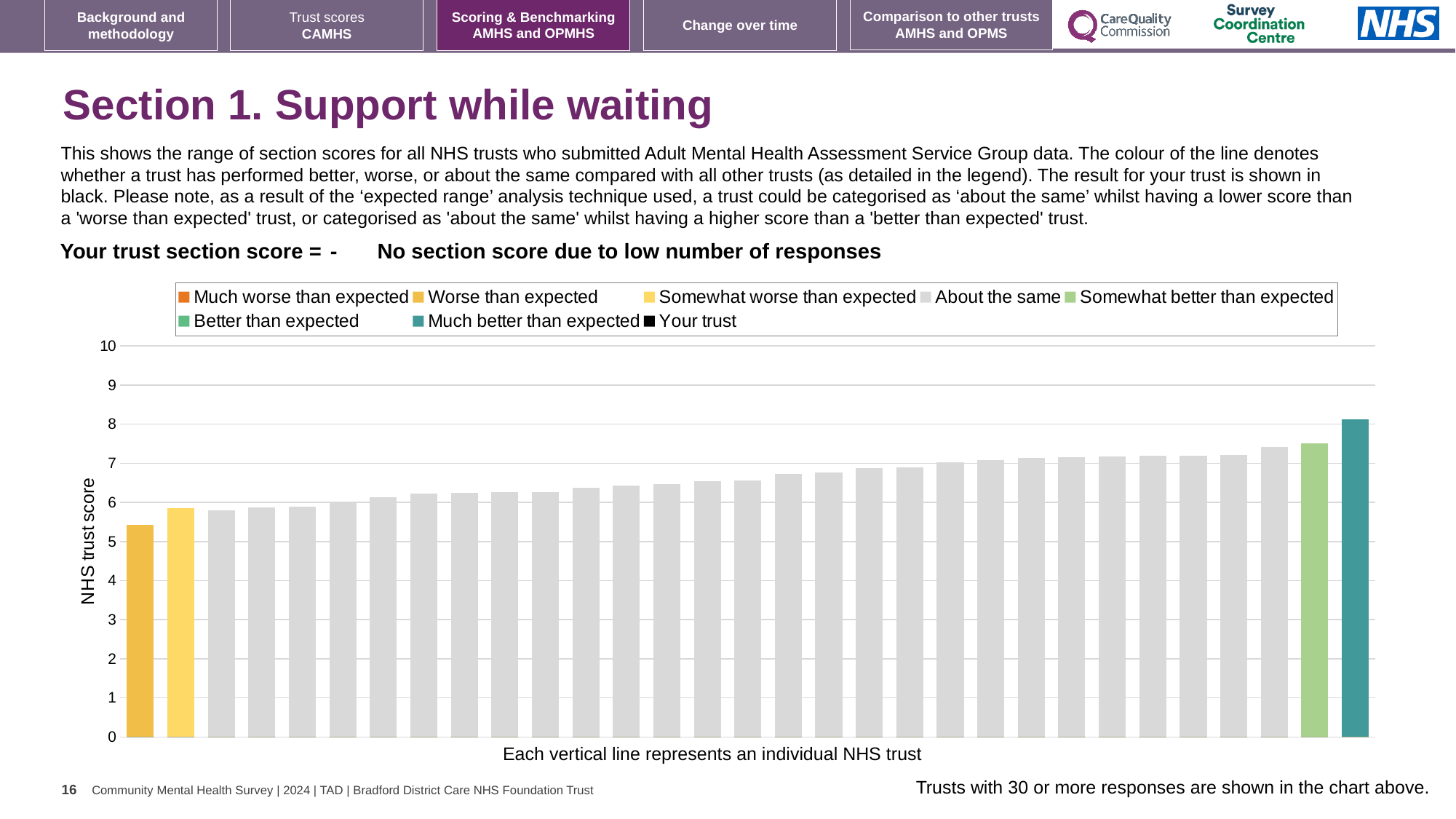
What is the label on the vertical axis of the chart? NHS trust score How many entries does the chart legend list? 8 Is the value of the leftmost bar greater or less than 5? greater Is the value of the leftmost bar greater or less than 6? less What is the highest value shown on the vertical axis of the chart? 10 Is the value of the light green bar (second from the right) greater or less than 8? less Do the bar values rise or fall from left to right across the chart? rise Which bar is the highest in the chart, the leftmost or the rightmost? rightmost What does each vertical line in the chart represent, according to the x-axis label? An individual NHS trust What kind of chart is shown on the slide? bar chart